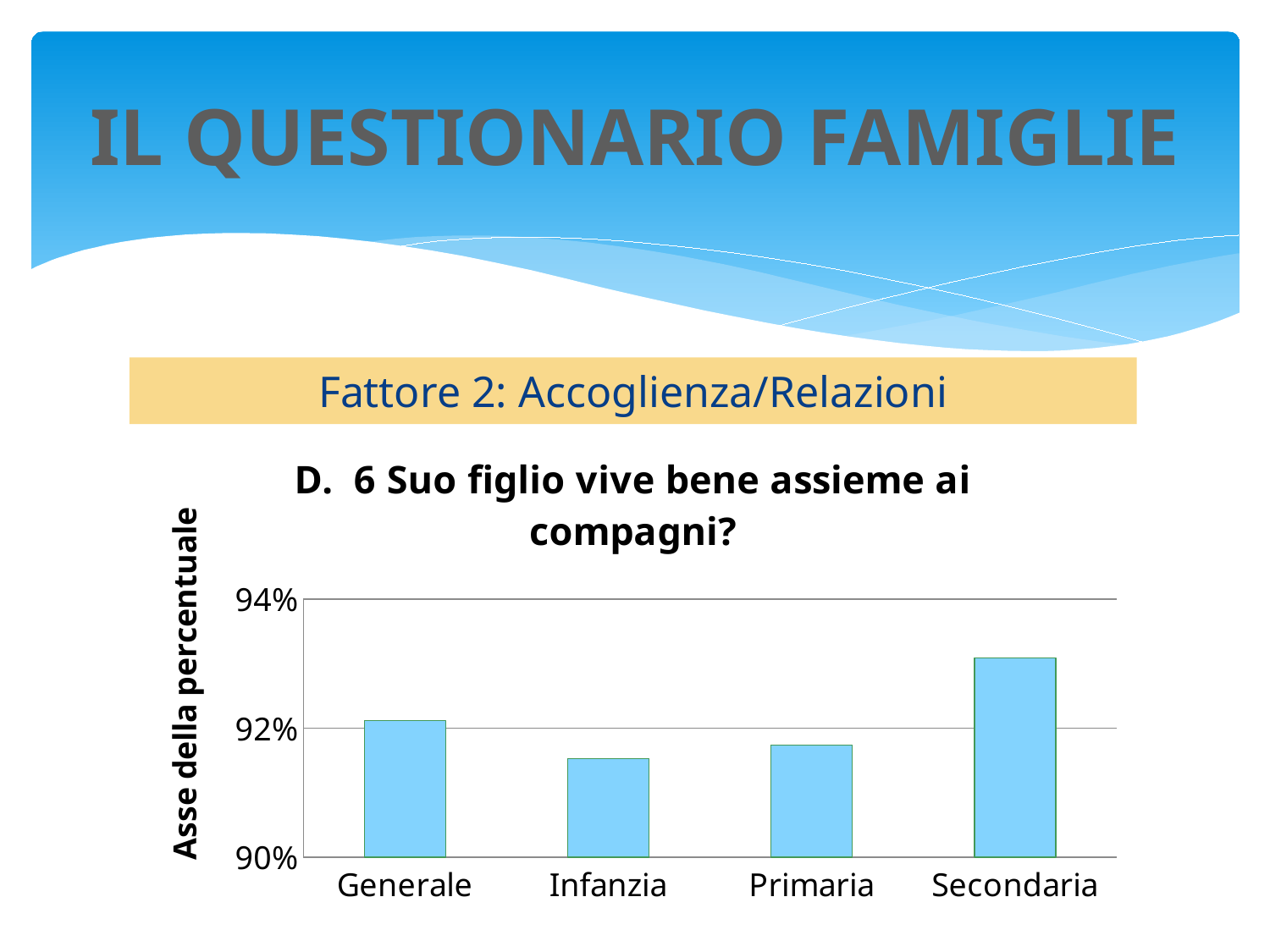
What is the label of the vertical axis of the chart? Asse della percentuale Is the value for Infanzia greater or less than 92%? less Which category has the lowest value in the chart? Infanzia How many categories are shown on the x axis of the chart? 4 Is the value for Secondaria greater or less than 94%? less Is the value for Secondaria greater or less than 92%? greater What is the title of the chart? D. 6 Suo figlio vive bene assieme ai compagni? Which is larger, the value for Primaria or the value for Infanzia? Primaria Which is larger, the value for Secondaria or the value for Generale? Secondaria Which category has the highest value in the chart? Secondaria What kind of chart is shown on the slide? bar chart